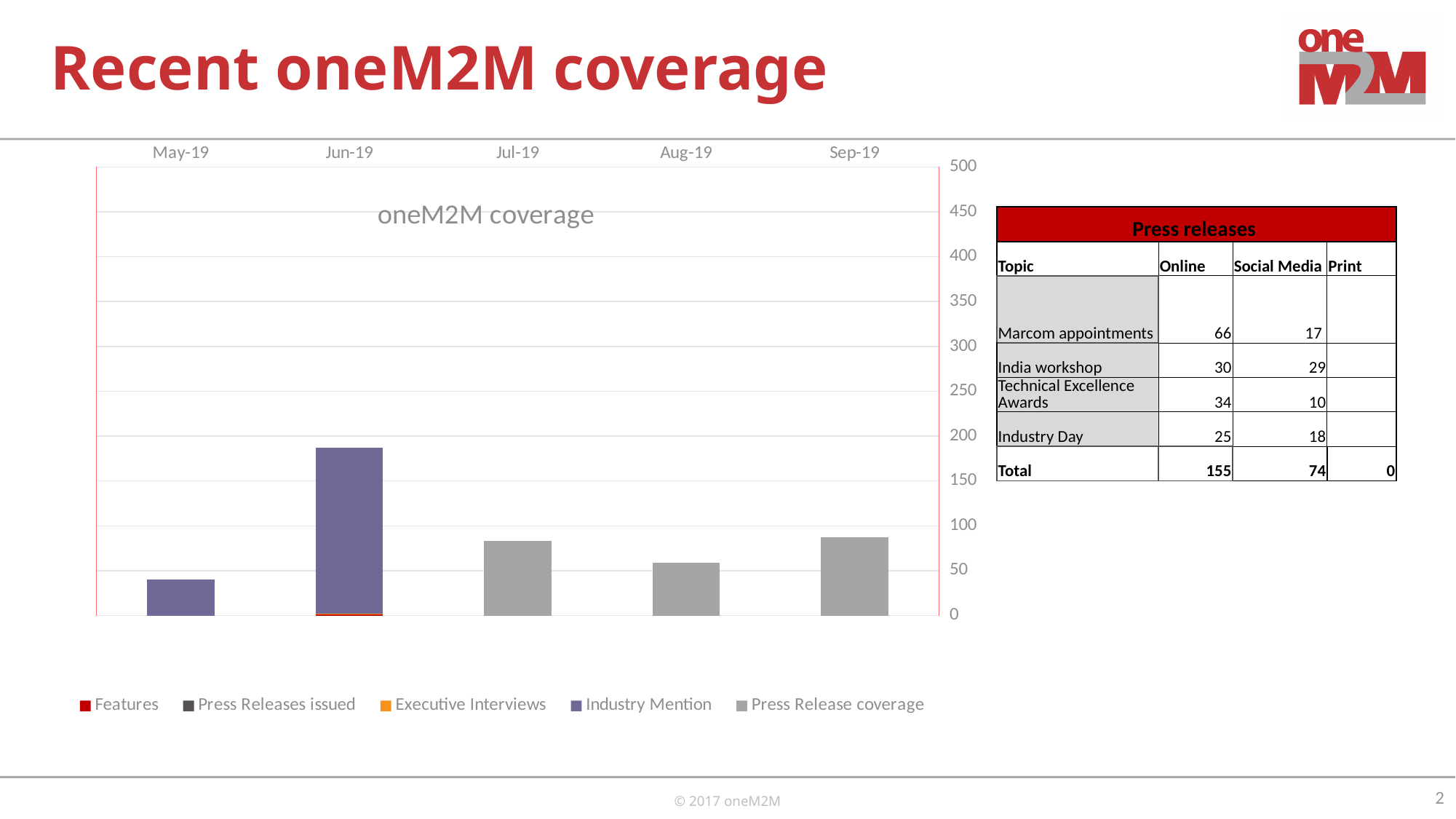
Is the value for Jul-19 greater or less than 100? less What kind of chart is shown on the slide? bar chart How many series does the chart legend list? 5 Which bar is taller, Aug-19 or Sep-19? Sep-19 What is the title of the chart? oneM2M coverage Which bar is taller, Jun-19 or Jul-19? Jun-19 Is the value for Sep-19 greater or less than 100? less Which month has the tallest bar in the chart? Jun-19 Is the value for May-19 greater or less than 50? less Which legend series is shown in purple? Industry Mention How many months are shown on the x axis of the chart? 5